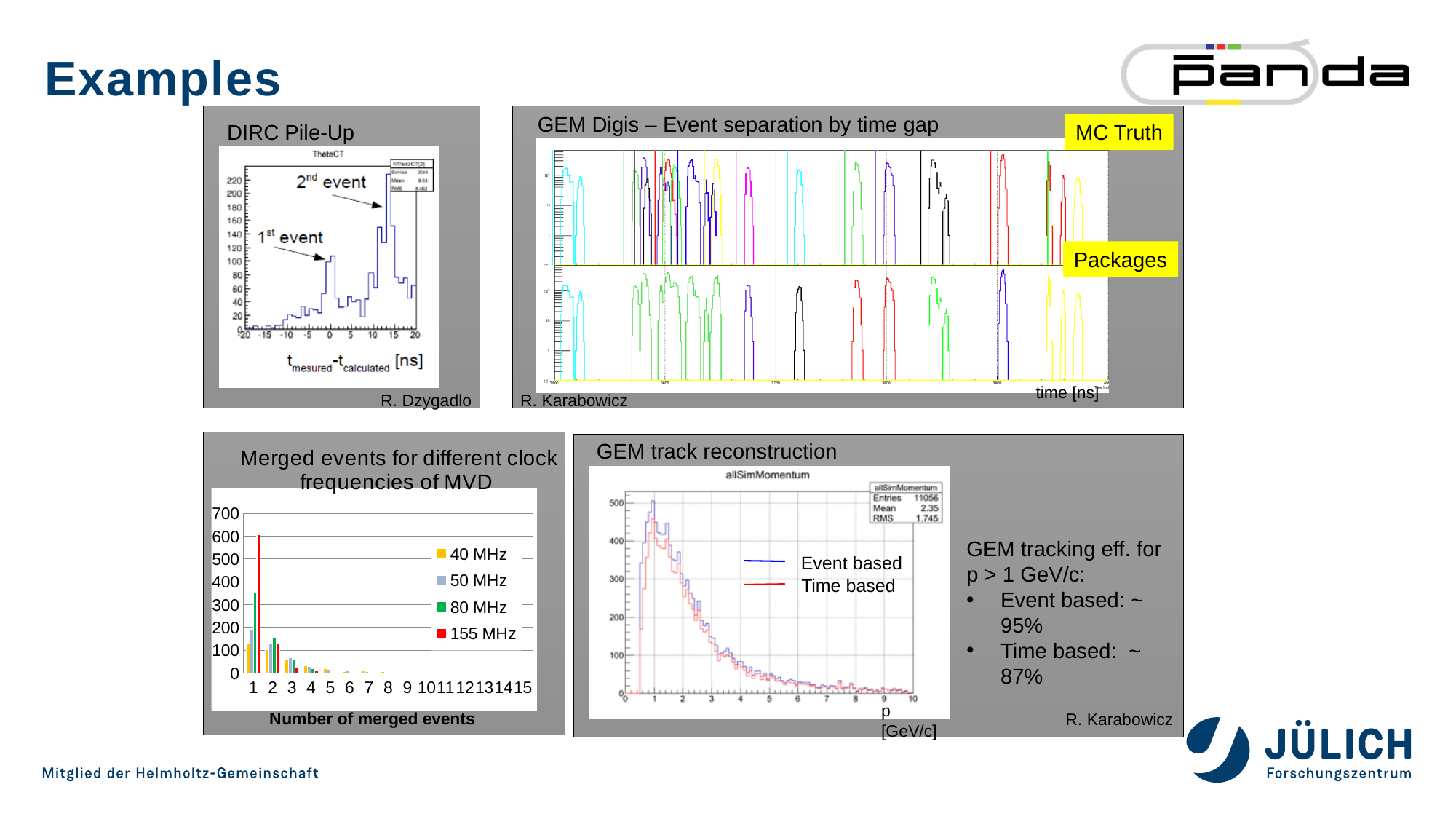
In the 'Merged events for different clock frequencies of MVD' chart, which series has the highest bar at 1 merged event? 155 MHz In the 'GEM track reconstruction' chart, what is the Mean shown in the statistics box? 2.35 In the 'Merged events for different clock frequencies of MVD' chart, how many series does the legend list? 4 In the 'Merged events for different clock frequencies of MVD' chart, which is larger at 2 merged events: 155 MHz or 40 MHz? 155 MHz In the 'Merged events for different clock frequencies of MVD' chart, is the 40 MHz value at 1 merged event greater or less than 200? less In the 'Merged events for different clock frequencies of MVD' chart, what colour represents the 155 MHz series? red In the 'Merged events for different clock frequencies of MVD' chart, is the 155 MHz value at 1 merged event greater or less than 500? greater In the 'GEM track reconstruction' chart, which colour represents the 'Time based' curve? red In the 'Merged events for different clock frequencies of MVD' chart, how many categories are shown on the x axis? 15 In the 'Merged events for different clock frequencies of MVD' chart, is the 80 MHz value at 1 merged event greater or less than 400? less What kind of chart is 'Merged events for different clock frequencies of MVD'? bar chart In the 'Merged events for different clock frequencies of MVD' chart, do the values rise or fall as the number of merged events increases? fall